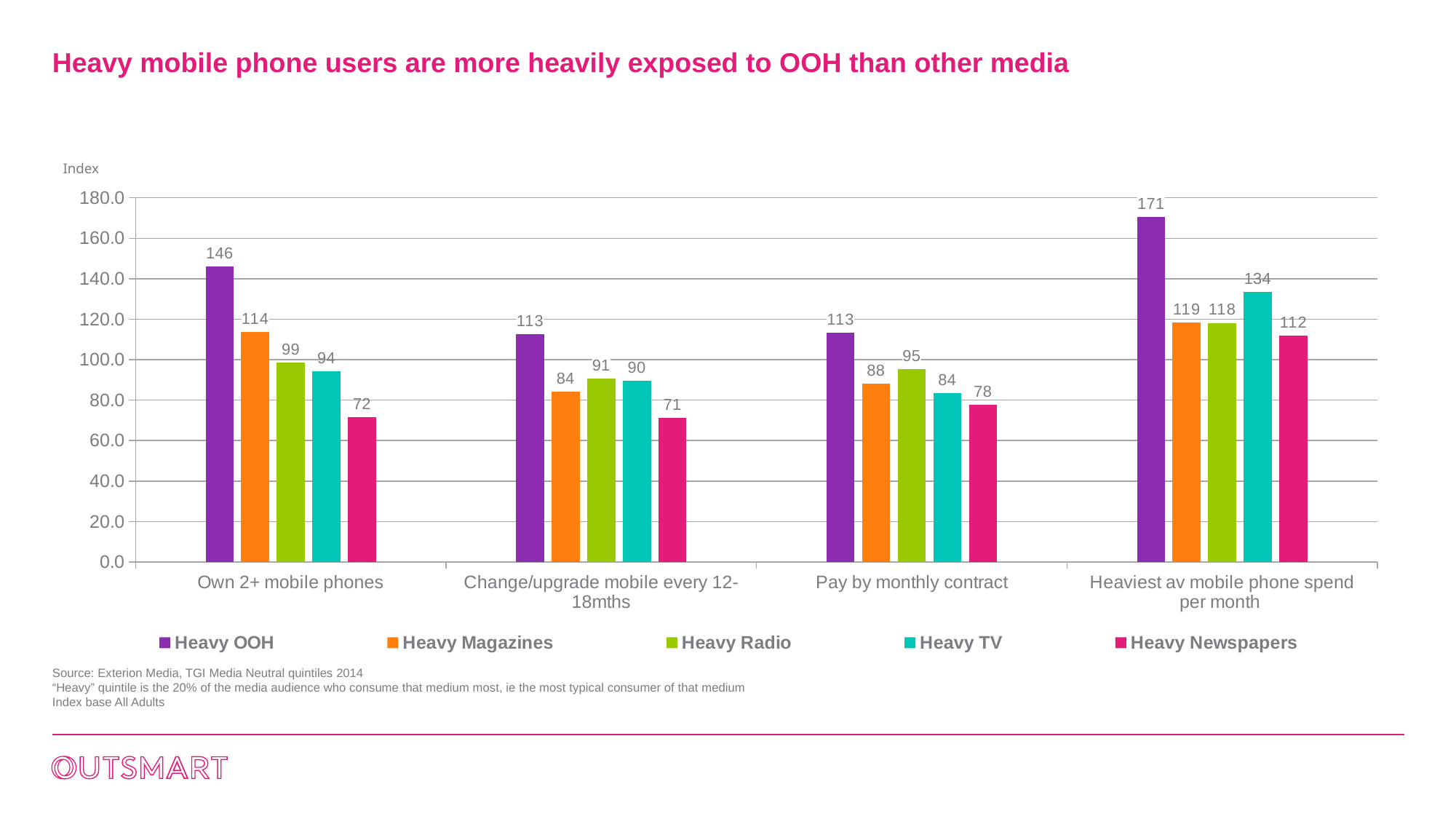
How many categories are shown on the x axis? 4 How many series does the legend list? 5 Which series has the lowest index for Pay by monthly contract? Heavy Newspapers What is the Heavy TV index for Heaviest av mobile phone spend per month? 134 What is the Heavy Newspapers index for Change/upgrade mobile every 12-18mths? 71 What kind of chart is shown on the slide? Bar chart What is the Heavy OOH index for Own 2+ mobile phones? 146 Is the Heavy OOH value for Heaviest av mobile phone spend per month greater or less than 160? greater For Heaviest av mobile phone spend per month, which is larger: Heavy TV or Heavy Magazines? Heavy TV Which category has the highest Heavy OOH index? Heaviest av mobile phone spend per month What is the difference between the Heavy OOH and Heavy Magazines index for Own 2+ mobile phones? 32 What is the label on the y axis? Index